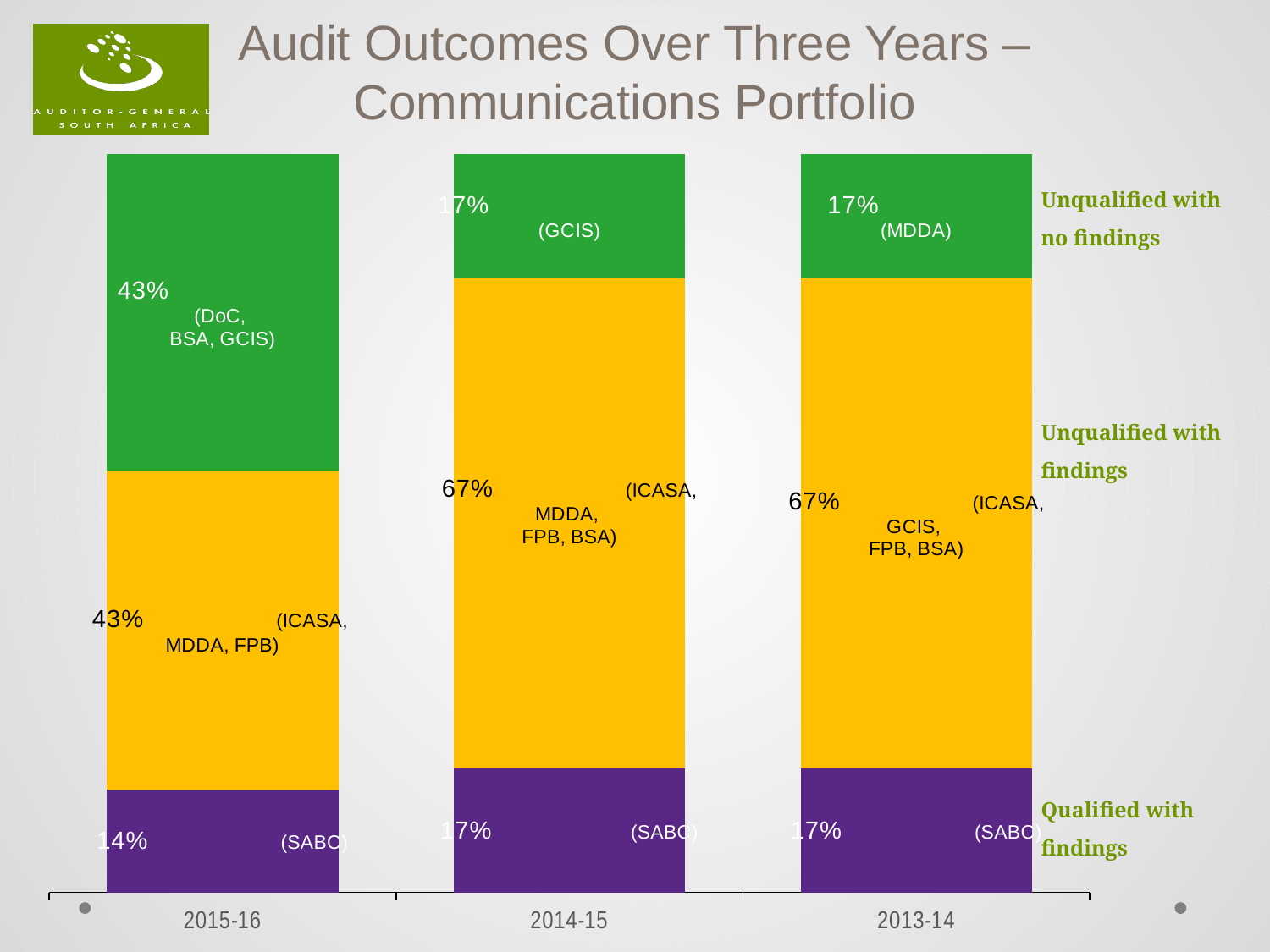
What percentage of the 2014-15 bar is 'Unqualified with findings'? 67% What is the difference between the 'Unqualified with findings' share in 2014-15 and in 2015-16? 24% Is the 'Unqualified with no findings' share larger in 2015-16 or in 2014-15? 2015-16 What percentage of the 2015-16 bar is 'Unqualified with no findings'? 43% Which entity is listed in the 'Unqualified with no findings' segment for 2014-15? GCIS Which entity is listed in the 'Qualified with findings' segment for all three years? SABC Which year has the lowest share of 'Qualified with findings'? 2015-16 What percentage of the 2013-14 bar is 'Unqualified with no findings'? 17% How many years (categories) are shown on the x axis? 3 What percentage of the 2015-16 bar is 'Qualified with findings'? 14% Which year has the highest share of 'Unqualified with no findings'? 2015-16 What type of chart is shown on the slide? Stacked bar chart